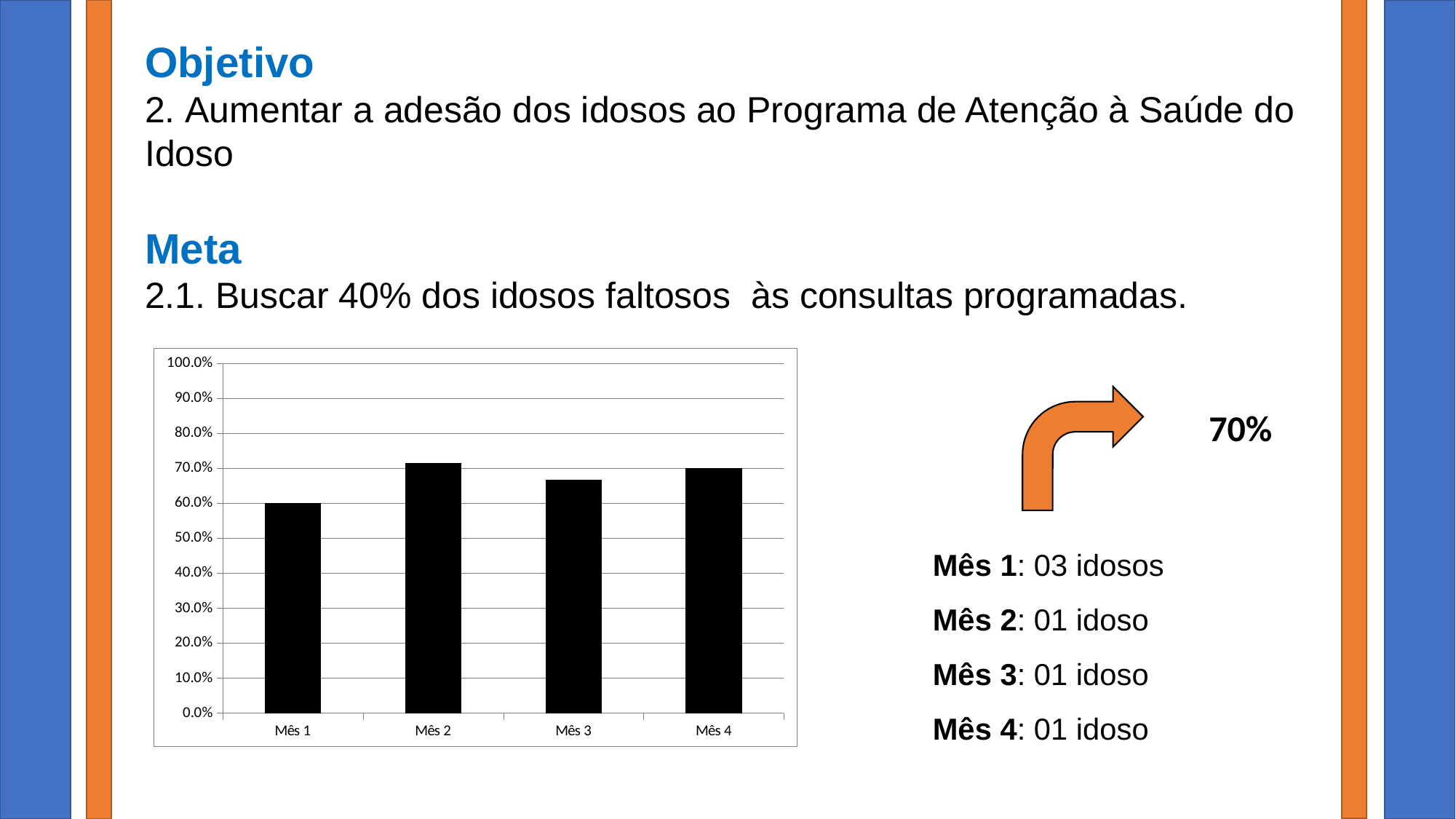
Is the value for Mês 2 greater or less than 60.0%? greater Which month has the lowest value in the bar chart? Mês 1 Is the value for Mês 3 greater or less than 60.0%? greater How many months are shown on the x axis of the chart? 4 Which is larger, the value for Mês 2 or the value for Mês 1? Mês 2 What is the value for Mês 1 in the bar chart? 60.0% Is the value for Mês 3 greater or less than 70.0%? less What is the value for Mês 4 in the bar chart? 70.0% Which is larger, the value for Mês 1 or the value for Mês 3? Mês 3 What kind of chart is shown on the slide? bar chart What is the maximum value shown on the y axis of the chart? 100.0%